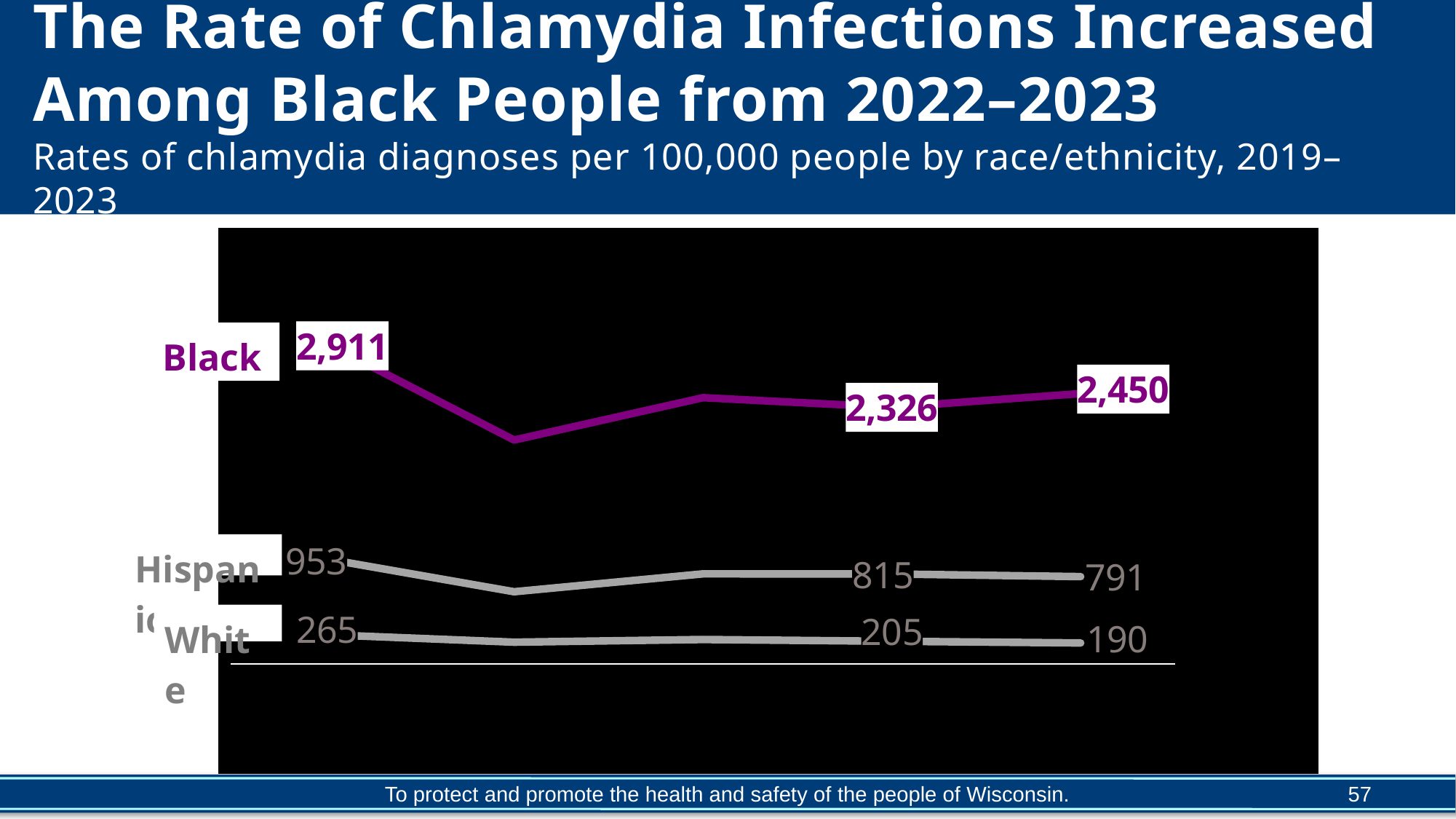
Which race/ethnicity group has the highest chlamydia rate across the chart? Black Does the rate for White people rise or fall from 2022 (205) to 2023 (190)? Fall What is the rate for Hispanic people in 2022, the second-to-last labeled point? 815 What is the difference between the Hispanic rate at the first point (953) and the last point (791)? 162 What is the rate for White people at the first point (2019)? 265 What is the rate of chlamydia diagnoses among Black people in 2023, the last point on the chart? 2,450 What colour is the line for Black people? Purple Which race/ethnicity group has the lowest chlamydia rate across the chart? White By how much did the rate among Black people increase from 2022 (2,326) to 2023 (2,450)? 124 What kind of chart is shown on the slide? Line chart How many race/ethnicity series are plotted on the chart? 3 For Black people, which year has the larger rate, 2022 or 2023? 2023